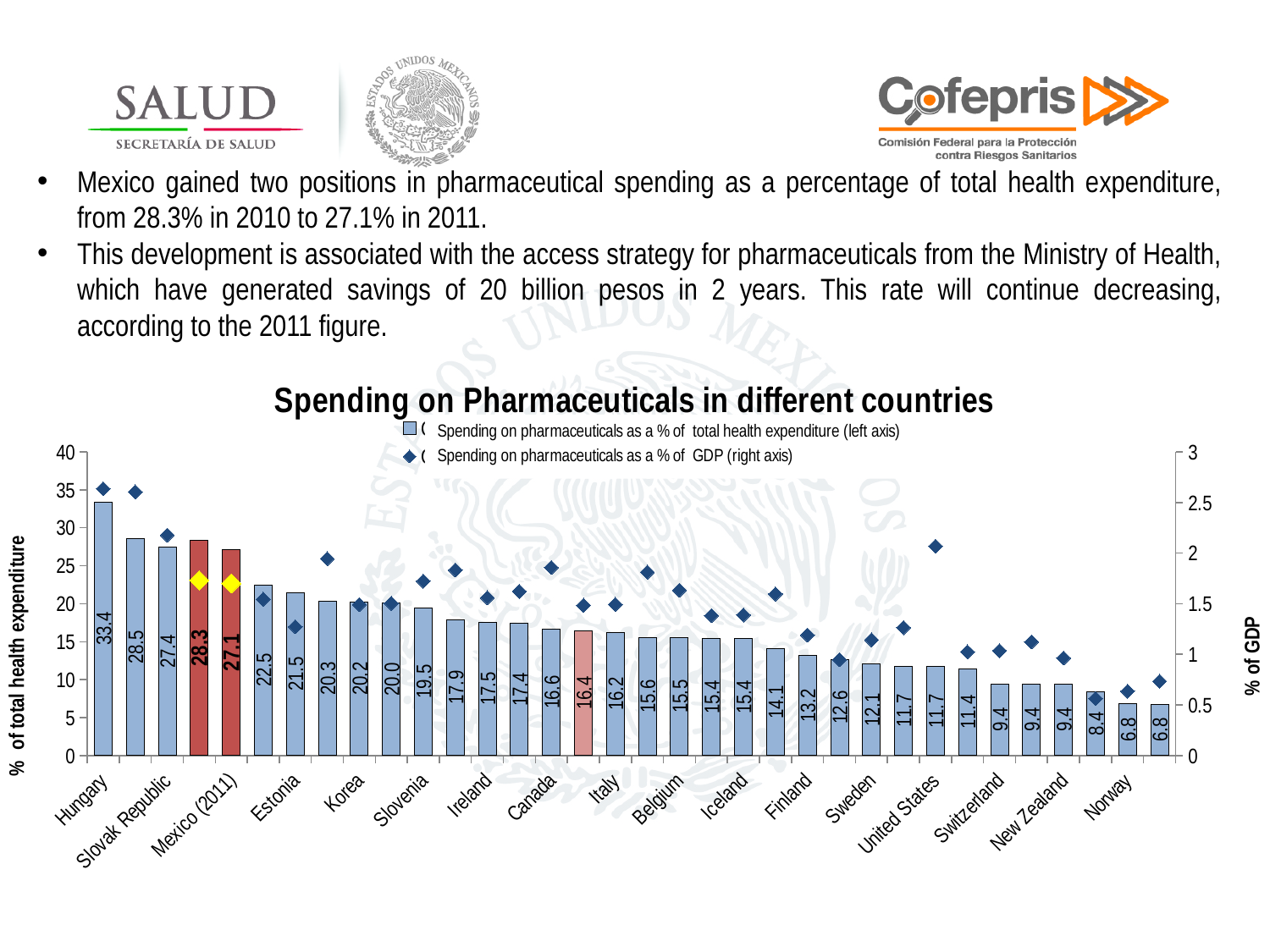
Which country has the highest spending on pharmaceuticals as a % of total health expenditure? Hungary Which has a higher spending on pharmaceuticals as a % of total health expenditure, Hungary or Norway? Hungary How many series does the legend list? 2 What is the spending on pharmaceuticals as a % of total health expenditure for Mexico (2011)? 27.1 What kind of chart is used to show spending on pharmaceuticals as a % of total health expenditure? Bar chart What is the spending on pharmaceuticals as a % of total health expenditure for Estonia? 21.5 What is the difference between Hungary's and Mexico (2011)'s spending on pharmaceuticals as a % of total health expenditure? 6.3 Is the spending on pharmaceuticals as a % of GDP for Norway greater or less than 1? less Do the bar values rise or fall from left to right across the countries? Fall What is the spending on pharmaceuticals as a % of total health expenditure for Hungary? 33.4 Is the spending on pharmaceuticals as a % of GDP for Mexico (2011) greater or less than 1.5? greater What is the spending on pharmaceuticals as a % of total health expenditure for Norway? 6.8